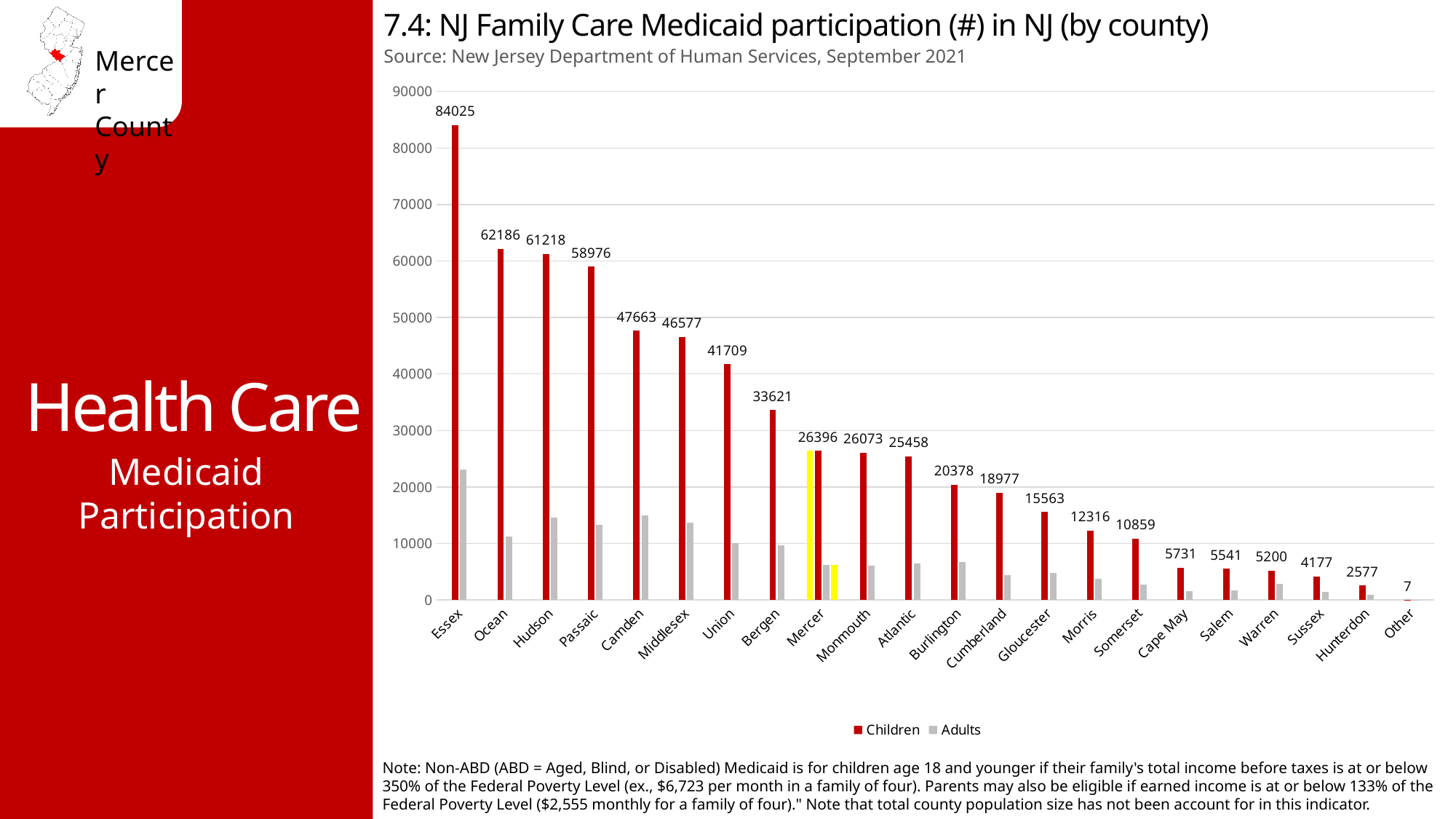
Is the Adults value for Essex greater or less than 20000? greater What kind of chart is shown? bar chart How many categories are shown on the x axis? 22 Which has a larger Children value, Camden or Union? Camden Which county has the highest Children value? Essex Which category has the lowest Children value? Other What is the Children value for Cape May? 5731 What is the Children value for Mercer? 26396 What is the difference between the Children values for Ocean and Hudson? 968 Is the Adults value for Mercer greater or less than 10000? less What is the Children value for Essex? 84025 How many series does the legend list? 2